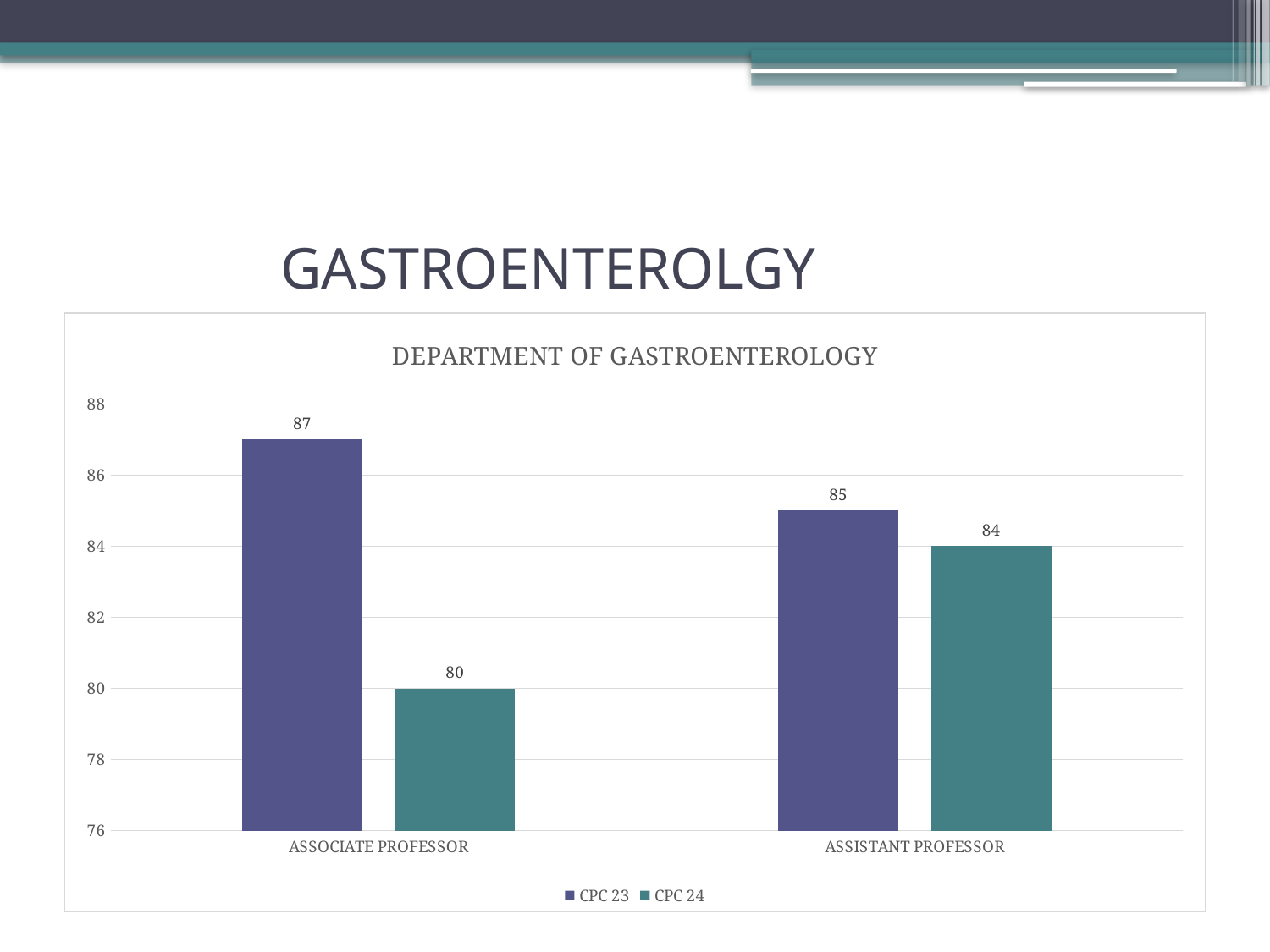
What is the CPC 23 value for ASSOCIATE PROFESSOR? 87 Which category has the highest CPC 23 value? ASSOCIATE PROFESSOR How many series does the legend list? 2 What is the CPC 24 value for ASSOCIATE PROFESSOR? 80 How many categories are shown on the x axis? 2 What kind of chart is shown on the slide? bar chart Which category has the lowest CPC 24 value? ASSOCIATE PROFESSOR What is the difference between the CPC 23 and CPC 24 values for ASSOCIATE PROFESSOR? 7 What is the difference between the CPC 23 and CPC 24 values for ASSISTANT PROFESSOR? 1 What is the CPC 23 value for ASSISTANT PROFESSOR? 85 Which is larger: the CPC 24 value for ASSISTANT PROFESSOR or the CPC 24 value for ASSOCIATE PROFESSOR? ASSISTANT PROFESSOR What is the CPC 24 value for ASSISTANT PROFESSOR? 84